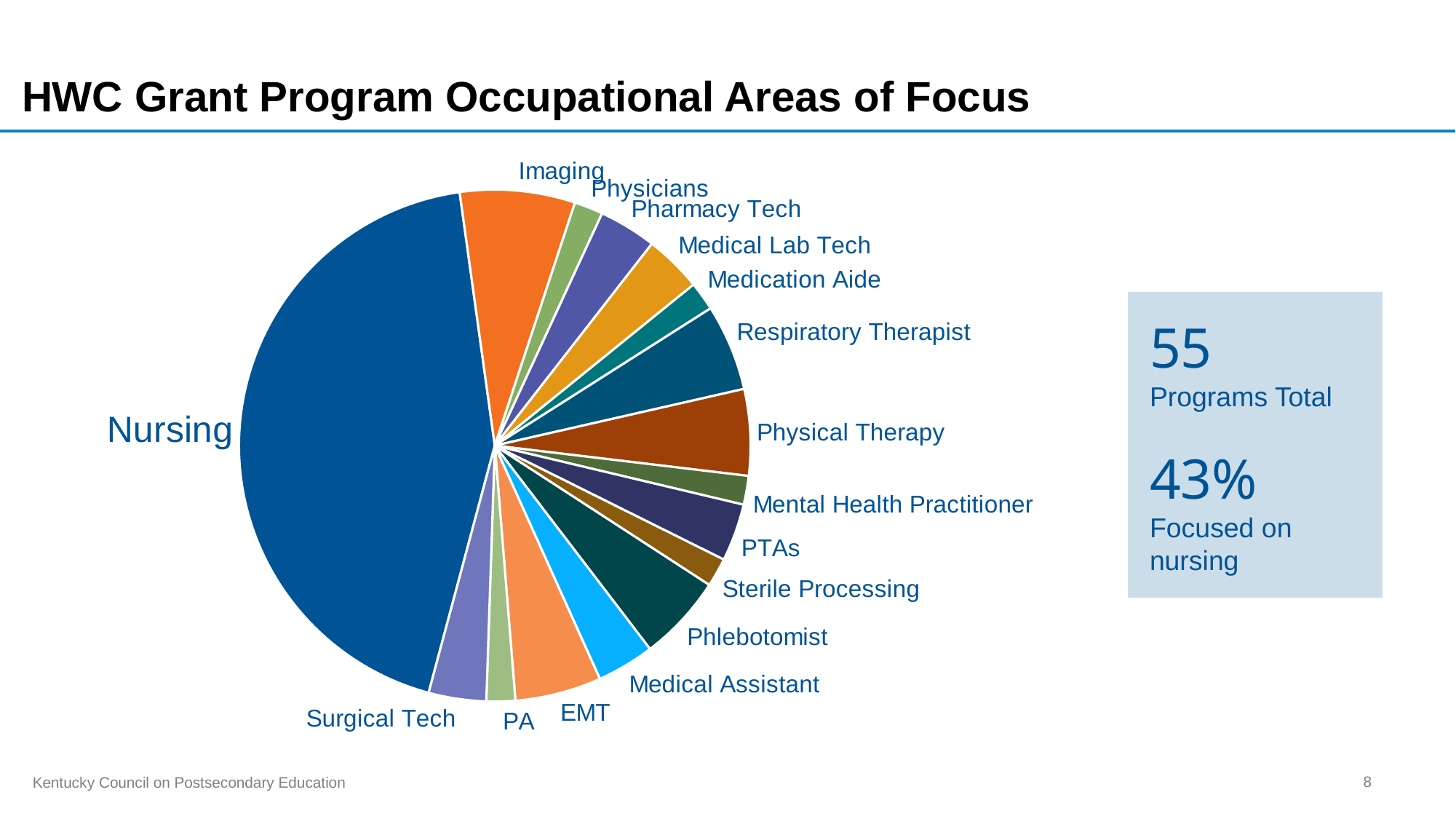
How many occupational categories are shown in the pie chart? 16 Which slice is larger, Physical Therapy or Medication Aide? Physical Therapy What is the title of the slide containing the pie chart? HWC Grant Program Occupational Areas of Focus Which slice is larger, Phlebotomist or Sterile Processing? Phlebotomist Which occupational area has the largest slice of the pie chart? Nursing What share of the programs is focused on nursing, according to the slide? 43% What kind of chart is shown on the slide? pie chart How many programs in total does the slide report? 55 Which slice is larger, Imaging or Physicians? Imaging